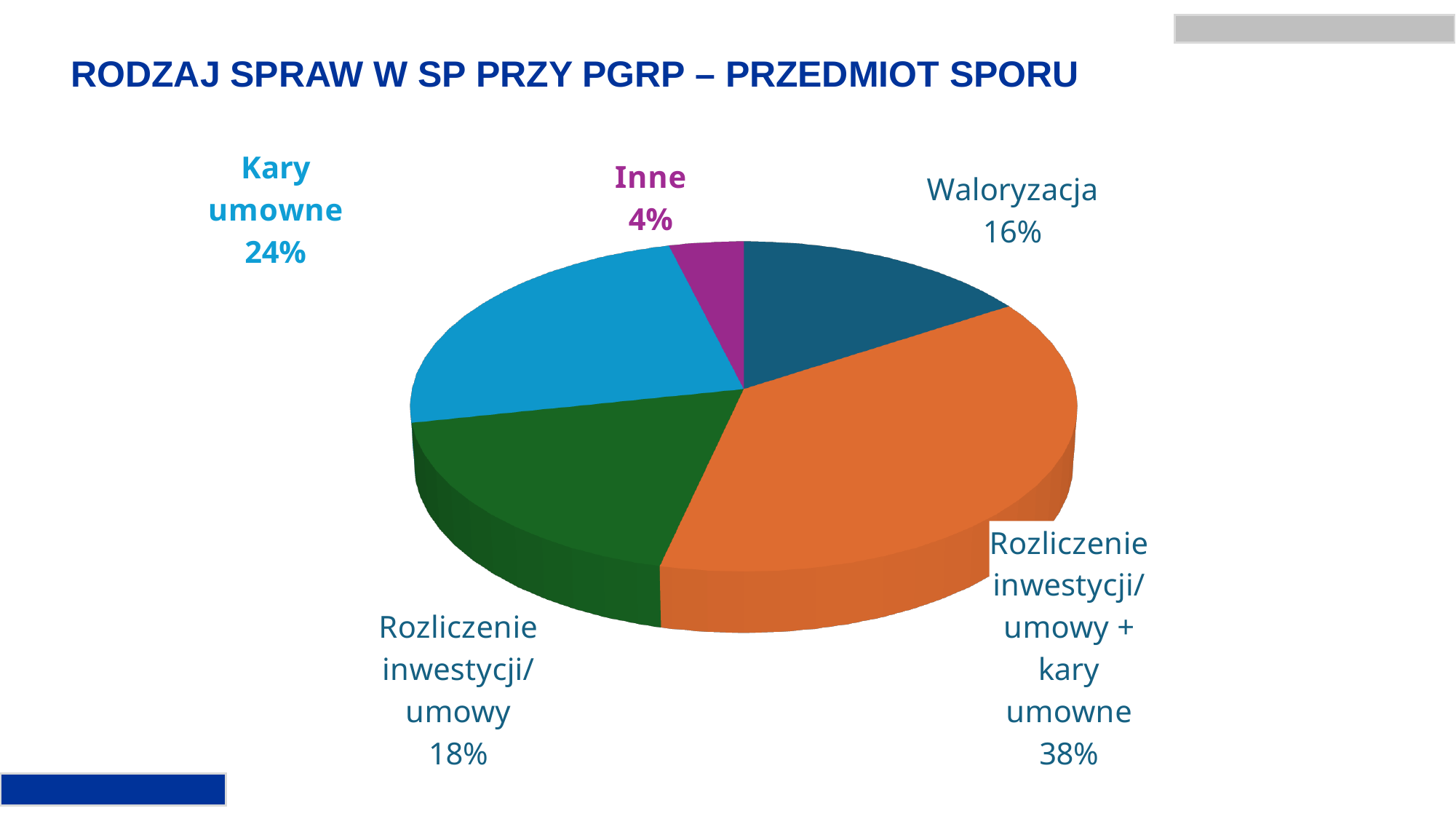
Which is larger, Waloryzacja or Rozliczenie inwestycji/umowy? Rozliczenie inwestycji/umowy Which category has the smallest slice of the pie? Inne What share of the pie does Kary umowne represent? 24% How many categories are shown in the pie chart? 5 What is the title of the slide? RODZAJ SPRAW W SP PRZY PGRP – PRZEDMIOT SPORU What kind of chart is shown on the slide? Pie chart What colour is the slice for Inne? Purple Which category has the largest slice of the pie? Rozliczenie inwestycji/umowy + kary umowne What is the value shown for Rozliczenie inwestycji/umowy? 18% What is the difference in percentage points between Rozliczenie inwestycji/umowy + kary umowne and Kary umowne? 14 What is the value shown for Inne? 4% What is the value shown for Waloryzacja? 16%